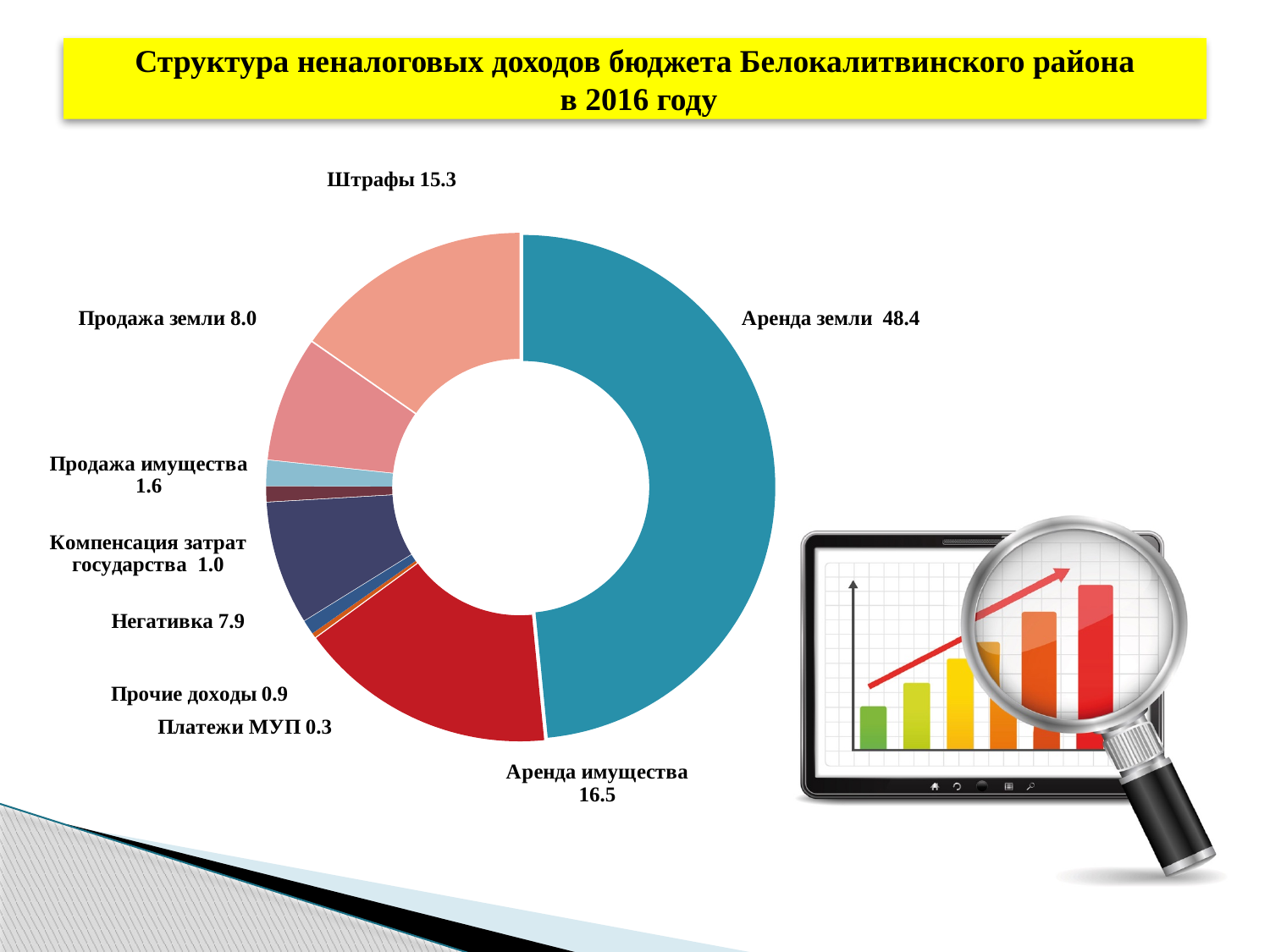
What is the value for Аренда земли? 48.4 What is the value for Негативка? 7.9 What kind of chart is shown on the slide? Pie (donut) chart What is the value for Платежи МУП? 0.3 What is the value for Аренда имущества? 16.5 What is the value for Штрафы? 15.3 What is the title of the slide? Структура неналоговых доходов бюджета Белокалитвинского района в 2016 году Which category has the smallest value? Платежи МУП How many categories are shown in the chart? 9 Which category has the largest value? Аренда земли What is the difference between Аренда имущества and Штрафы? 1.2 Which is larger, Продажа земли or Негативка? Продажа земли